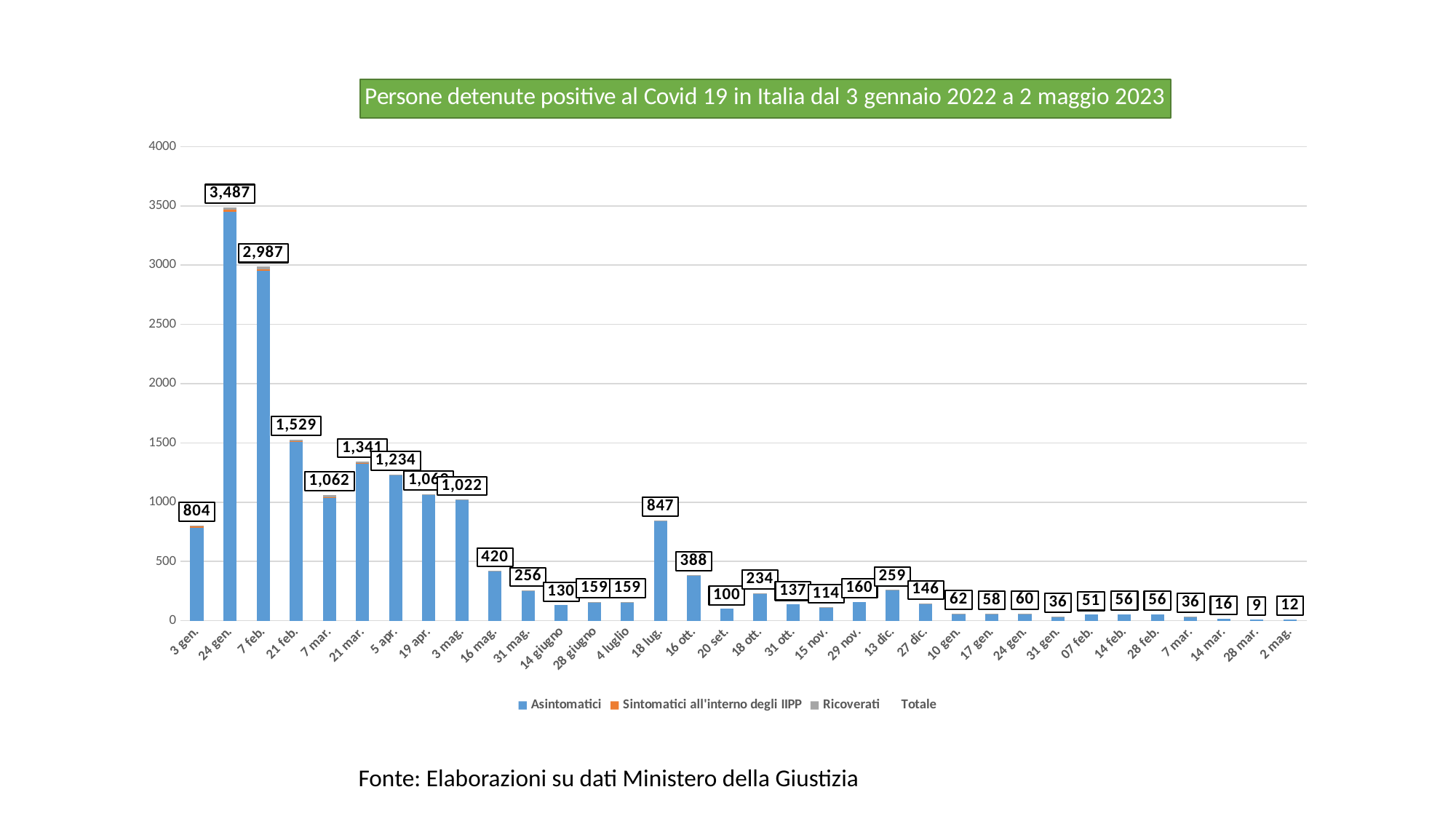
How many series does the legend list? 4 Which has a larger total, 21 mar. or 5 apr.? 21 mar. Which date has the lowest total? 28 mar. What is the total value labelled for 13 dic.? 259 What is the total value labelled for 18 lug.? 847 Overall, do the totals rise or fall from left to right along the x axis? fall Which date has the highest total? 24 gen. (the second bar) What kind of chart is shown on the slide? bar chart What is the difference between the totals for the second bar (24 gen.) and 7 feb.? 500 What is the total value labelled for 3 gen., the first bar? 804 What is the total value labelled for 16 ott.? 388 Is the value for 7 feb. greater or less than 2500? greater